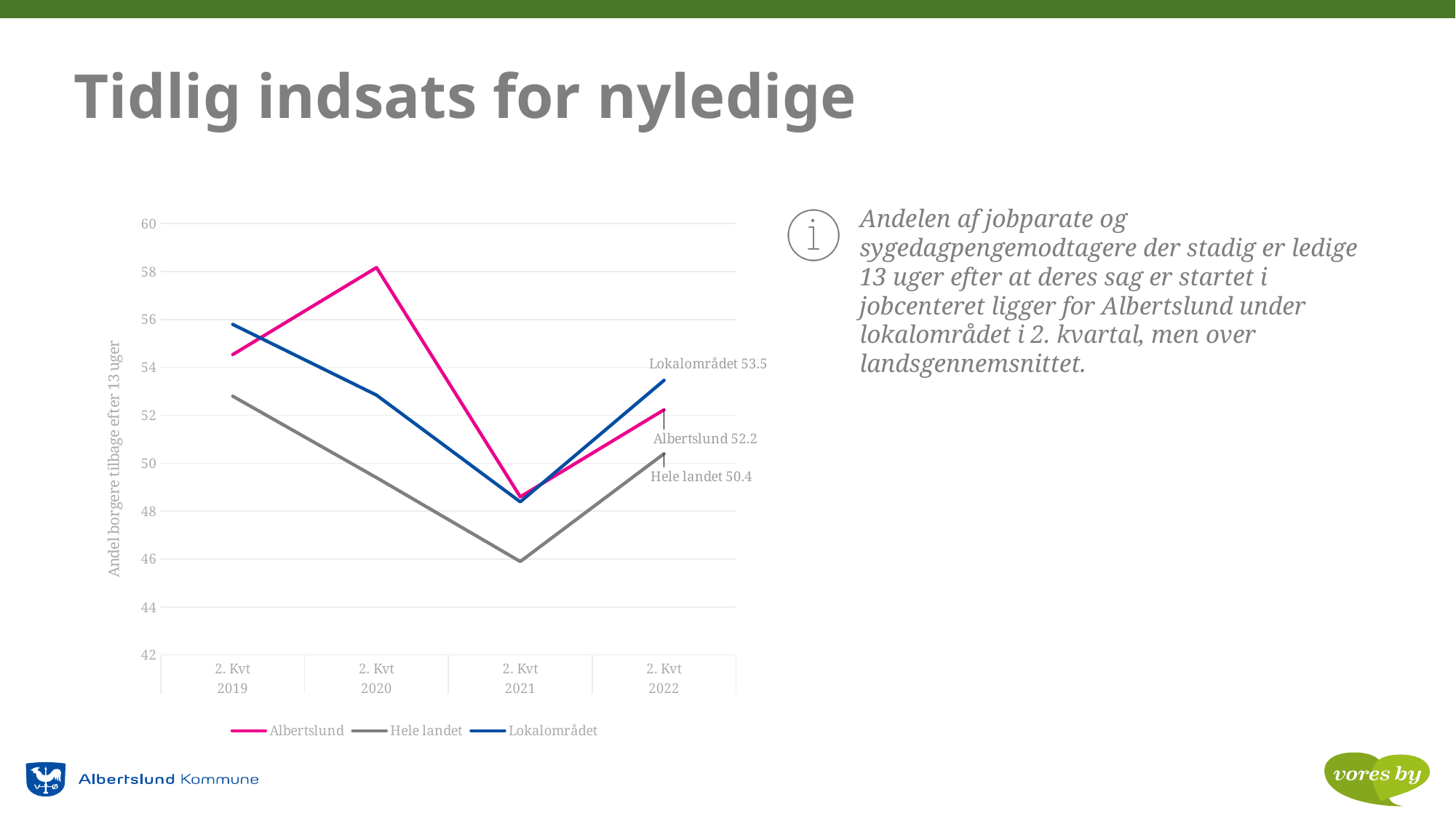
What is the value for Hele landet in 2. Kvt 2022? 50.4 What is the value for Albertslund in 2. Kvt 2022? 52.2 Does the value for Hele landet rise or fall from 2. Kvt 2019 to 2. Kvt 2021? fall What is the difference between Lokalområdet and Albertslund in 2. Kvt 2022? 1.3 What kind of chart is shown on the slide? line chart What is the value for Lokalområdet in 2. Kvt 2022? 53.5 Is the value for Hele landet in 2. Kvt 2021 greater or less than 48? less Which is larger in 2. Kvt 2022, Albertslund or Hele landet? Albertslund Is the value for Albertslund in 2. Kvt 2020 greater or less than 56? greater Which series has the highest value in 2. Kvt 2022? Lokalområdet How many series does the legend list? 3 Which series has the lowest value in 2. Kvt 2022? Hele landet